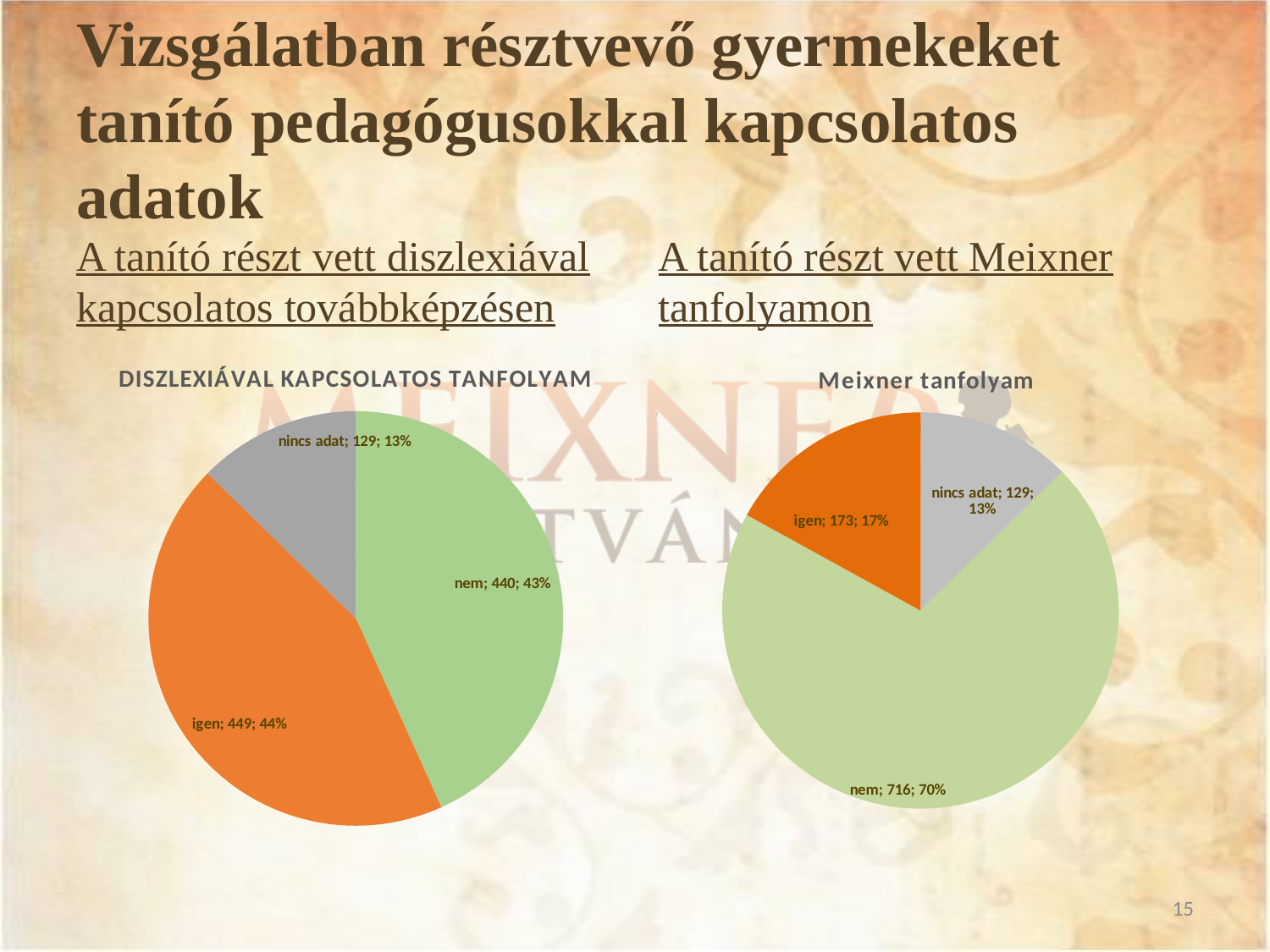
In the 'DISZLEXIÁVAL KAPCSOLATOS TANFOLYAM' chart, which category has the smallest slice? nincs adat What type of chart is the 'Meixner tanfolyam' chart? Pie chart In the 'DISZLEXIÁVAL KAPCSOLATOS TANFOLYAM' chart, what colour is the 'igen' slice? Orange In the 'DISZLEXIÁVAL KAPCSOLATOS TANFOLYAM' chart, what percentage share does 'nem' have? 43% In the 'DISZLEXIÁVAL KAPCSOLATOS TANFOLYAM' chart, what is the difference between the 'igen' and 'nem' counts? 9 In the 'Meixner tanfolyam' chart, what is the count for 'nem'? 716 In the 'Meixner tanfolyam' chart, which is larger, the 'igen' count or the 'nincs adat' count? igen In the 'Meixner tanfolyam' chart, what is the difference between the 'nem' and 'igen' counts? 543 In the 'DISZLEXIÁVAL KAPCSOLATOS TANFOLYAM' chart, what is the count for 'igen'? 449 In the 'Meixner tanfolyam' chart, what percentage share does 'igen' have? 17% In the 'DISZLEXIÁVAL KAPCSOLATOS TANFOLYAM' chart, how many slices does the pie have? 3 In the 'Meixner tanfolyam' chart, which category has the largest slice? nem